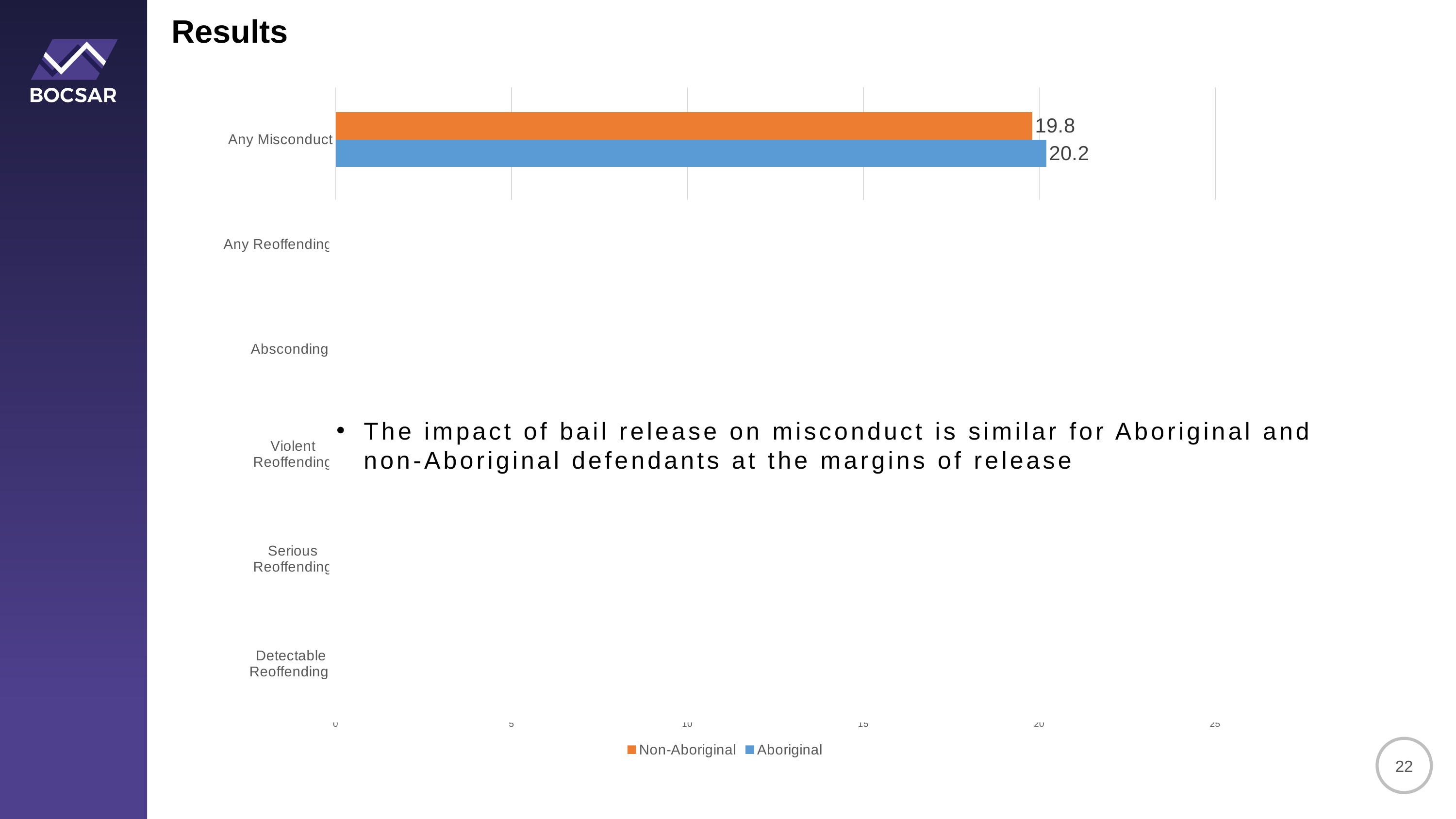
What kind of chart is shown on the slide? Bar chart For Any Misconduct, which series has the larger value, Aboriginal or Non-Aboriginal? Aboriginal What is the value for Aboriginal defendants for Any Misconduct? 20.2 Is the Aboriginal value for Any Misconduct greater or less than 25? less How many categories are listed on the vertical axis of the chart? 6 What is the difference between the Aboriginal and Non-Aboriginal values for Any Misconduct? 0.4 How many series does the legend list? 2 Which colour represents the Non-Aboriginal series in the legend? Orange Which category has bars plotted with data labels? Any Misconduct Is the Non-Aboriginal value for Any Misconduct greater or less than 15? greater What is the value for Non-Aboriginal defendants for Any Misconduct? 19.8